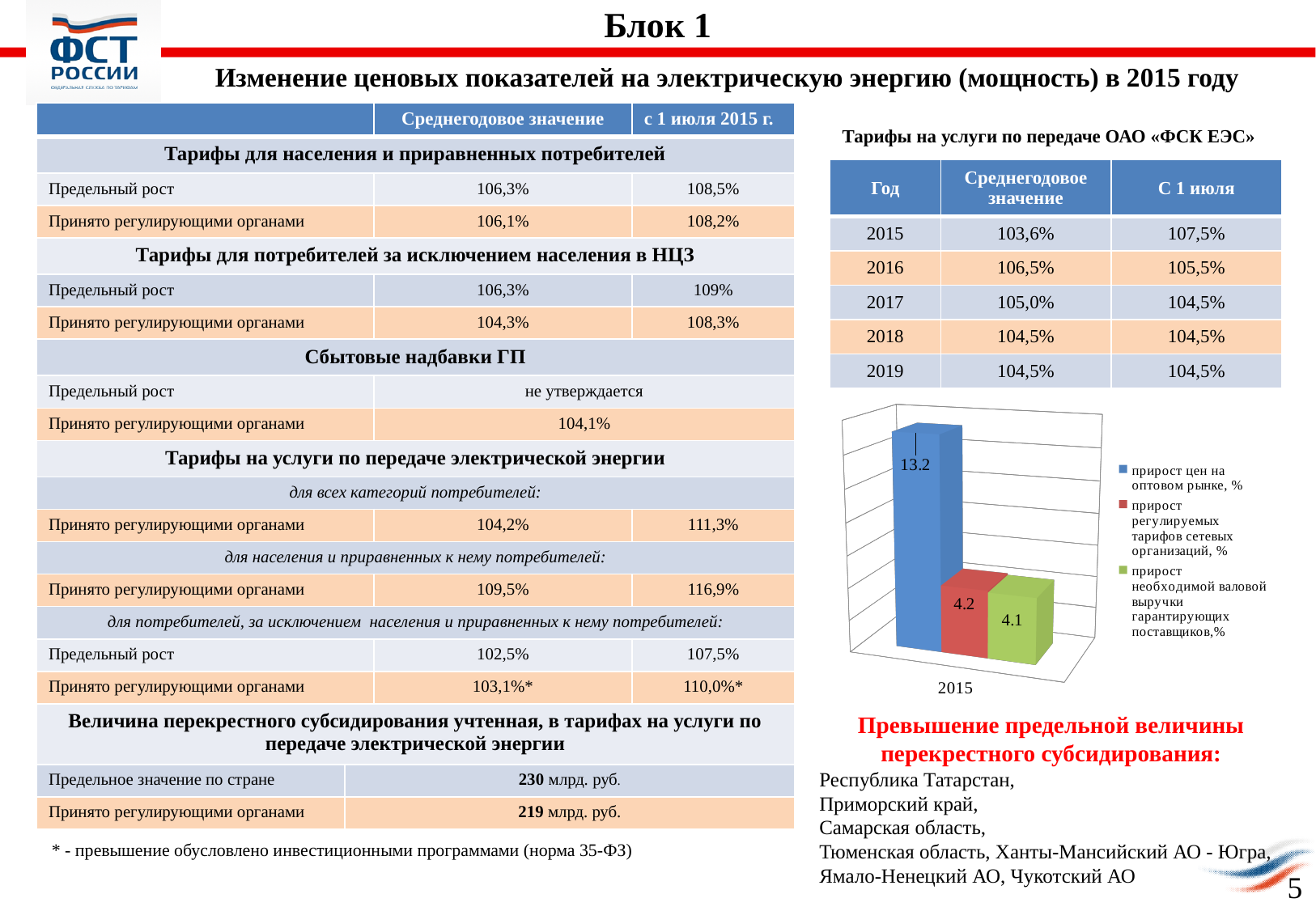
What is the difference between the value for "прирост регулируемых тарифов сетевых организаций, %" and the value for "прирост необходимой валовой выручки гарантирующих поставщиков,%"? 0.1 What year is shown as the category label on the x axis of the chart? 2015 Which series has the lowest value in the chart? прирост необходимой валовой выручки гарантирующих поставщиков,% What is the value for "прирост регулируемых тарифов сетевых организаций, %" in 2015? 4.2 How many series does the chart legend list? 3 What is the value for "прирост необходимой валовой выручки гарантирующих поставщиков,%" in 2015? 4.1 What is the difference between the value for "прирост цен на оптовом рынке, %" and the value for "прирост регулируемых тарифов сетевых организаций, %"? 9 How many categories are shown on the x axis of the chart? 1 What is the value for "прирост цен на оптовом рынке, %" in 2015? 13.2 What type of chart is shown on the slide? bar chart Which is larger: the value for "прирост цен на оптовом рынке, %" or the value for "прирост необходимой валовой выручки гарантирующих поставщиков,%"? прирост цен на оптовом рынке, % Which series has the highest value in the chart? прирост цен на оптовом рынке, %